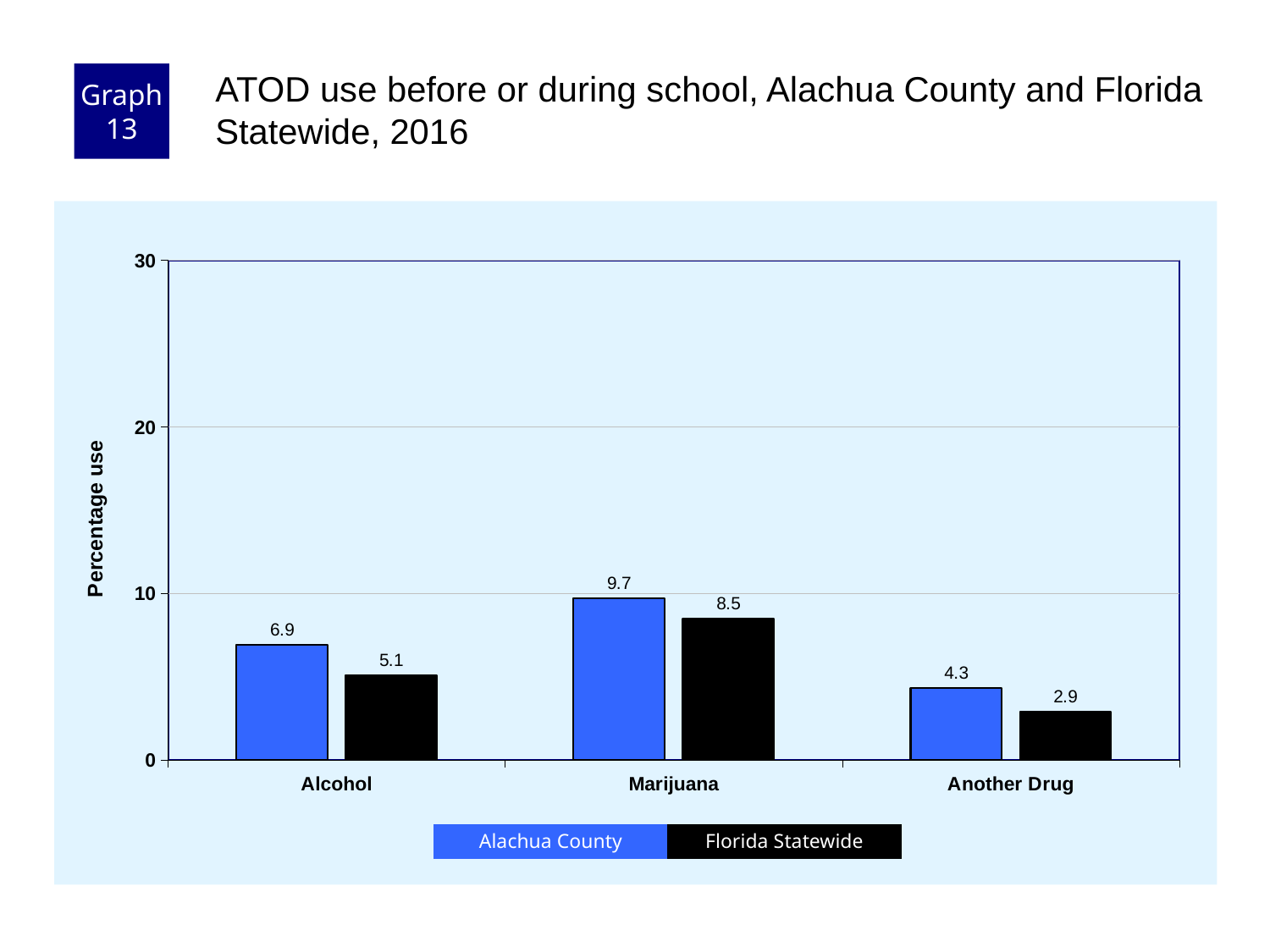
Which category has the highest Alachua County value? Marijuana How many series does the legend list? 2 What kind of chart is shown on the slide? bar chart What is the difference between the Alachua County values for Marijuana and Another Drug? 5.4 How many categories are shown on the x axis? 3 What is the Florida Statewide value for Another Drug? 2.9 What is the difference between the Alachua County and Florida Statewide values for Alcohol? 1.8 Which is larger for Another Drug: Alachua County or Florida Statewide? Alachua County What is the Alachua County value for Marijuana? 9.7 Is the Florida Statewide value for Marijuana greater or less than 10? less Which category has the lowest Florida Statewide value? Another Drug What is the Florida Statewide value for Alcohol? 5.1